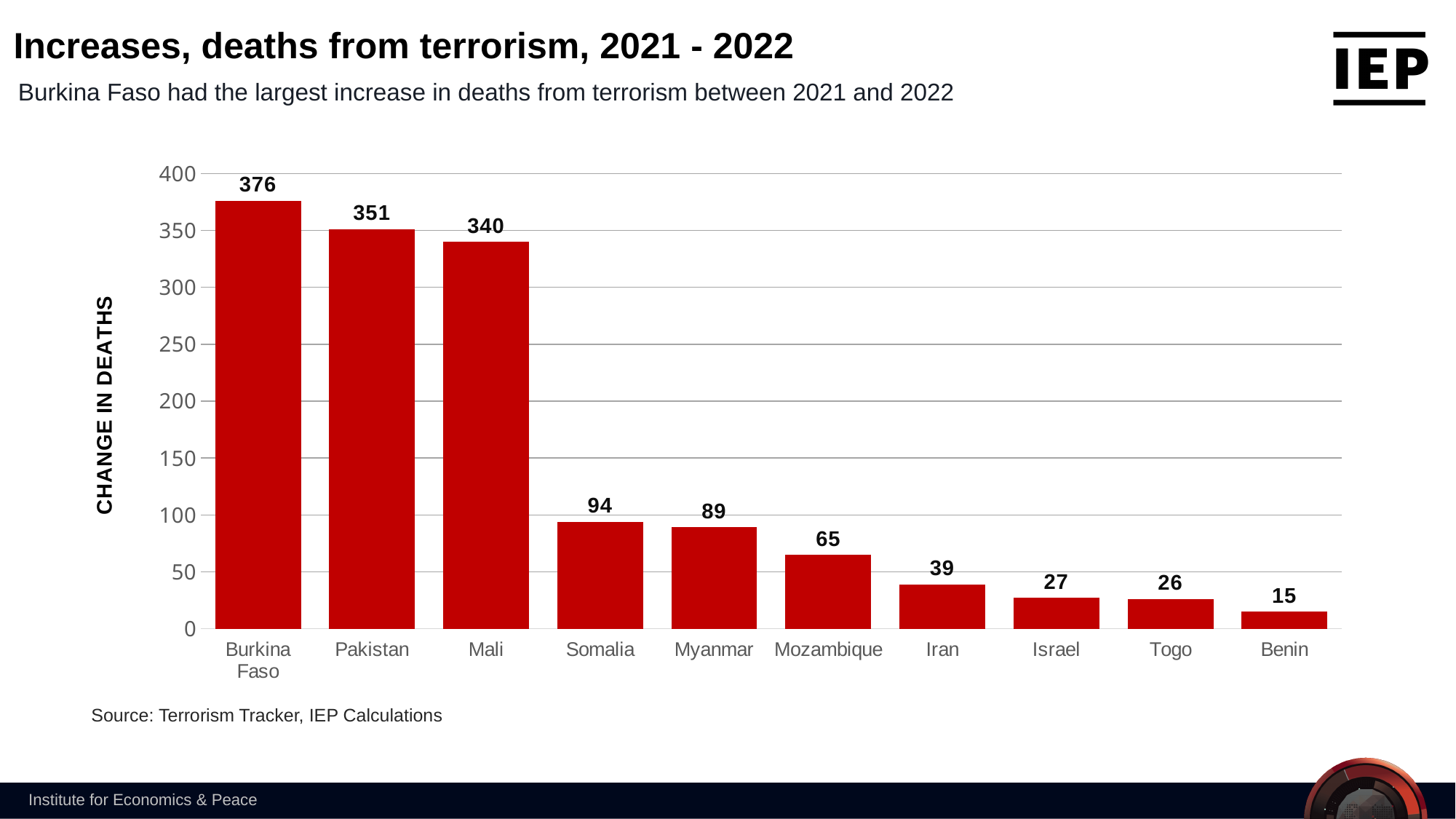
How many countries are shown in the chart? 10 What is the difference in change in deaths between Burkina Faso and Mali? 36 Which country has the smallest change in deaths? Benin What is the change in deaths for Mozambique? 65 Is the value for Mali greater or less than 300? greater Which has a larger change in deaths, Iran or Israel? Iran What is the label on the vertical axis of the chart? CHANGE IN DEATHS What is the change in deaths for Togo? 26 What is the difference in change in deaths between Somalia and Myanmar? 5 What is the change in deaths for Pakistan? 351 Which country has the largest change in deaths? Burkina Faso What kind of chart is shown on the slide? bar chart